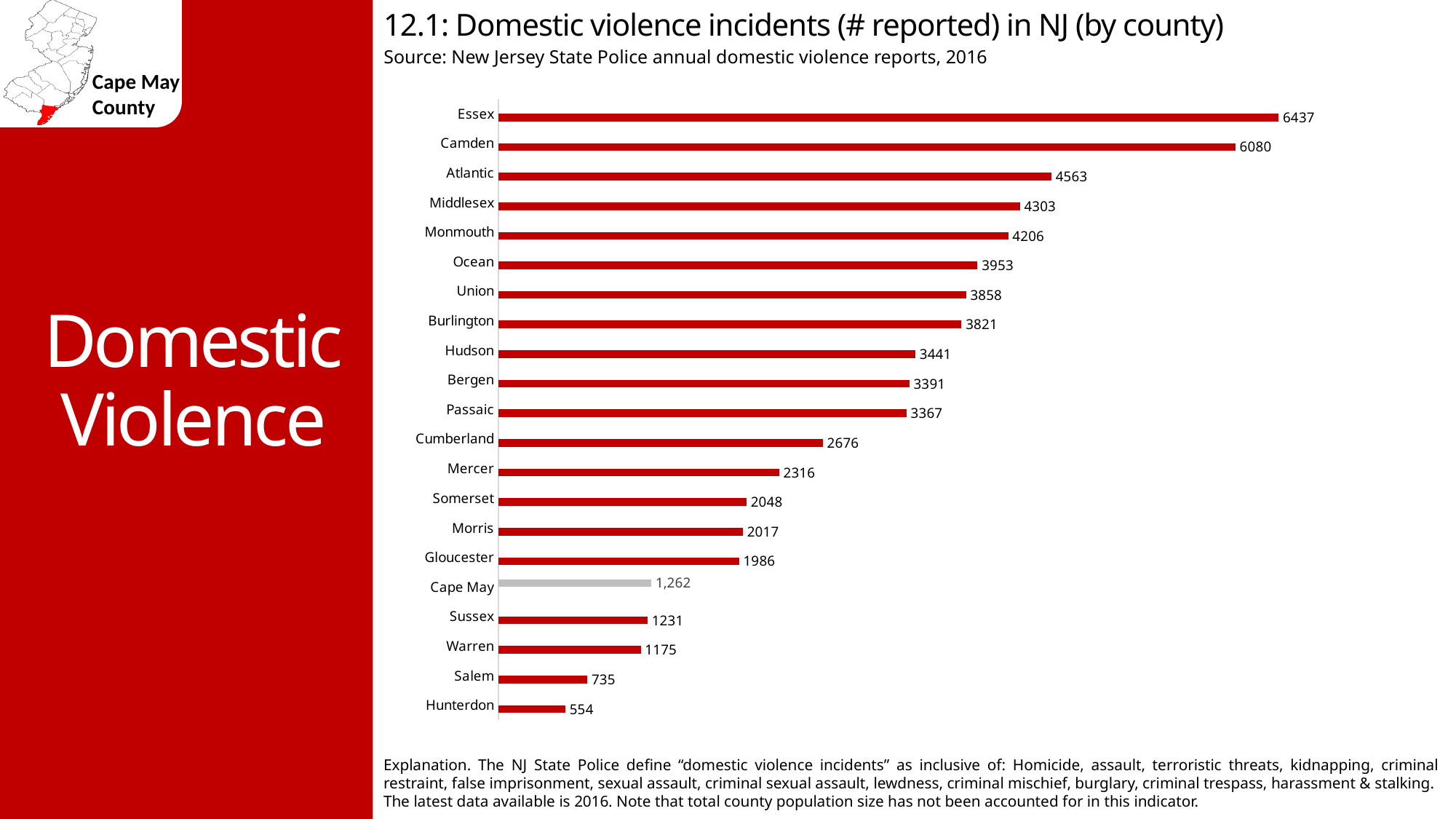
Which county reported more domestic violence incidents, Atlantic or Middlesex? Atlantic Which county has the highest number of reported domestic violence incidents? Essex Which county's bar is coloured grey instead of red? Cape May How many domestic violence incidents were reported in Cape May County? 1,262 Which county reported more domestic violence incidents, Salem or Warren? Warren How many domestic violence incidents were reported in Essex County? 6437 What type of chart is used on this slide? Bar chart What is the difference between the number of incidents in Essex and Camden? 357 How many domestic violence incidents were reported in Gloucester County? 1986 What is the difference between the number of incidents in Cape May and Sussex? 31 How many counties are shown in the chart? 21 Which county has the lowest number of reported domestic violence incidents? Hunterdon